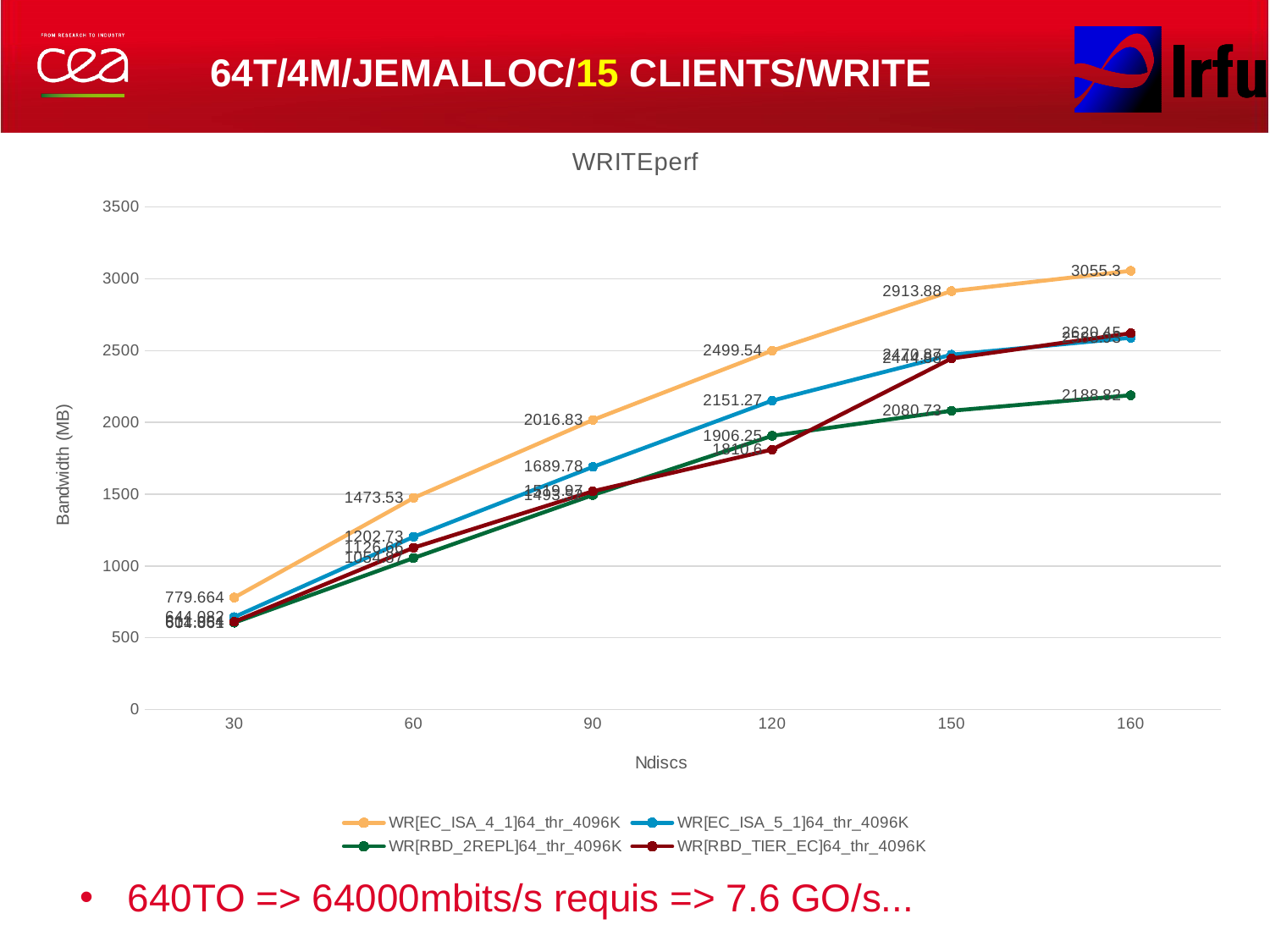
What is the bandwidth for WR[EC_ISA_5_1]64_thr_4096K at 120 Ndiscs? 2151.27 What kind of chart is shown on the slide? line chart How many Ndiscs values are plotted along the x axis of the WRITEperf chart? 6 Does the bandwidth for WR[EC_ISA_4_1]64_thr_4096K rise or fall as Ndiscs increases? rises What is the difference between the WR[EC_ISA_4_1]64_thr_4096K values at 160 and 150 Ndiscs? 141.42 What is the bandwidth for WR[EC_ISA_4_1]64_thr_4096K at 160 Ndiscs? 3055.3 What is the bandwidth for WR[RBD_2REPL]64_thr_4096K at 150 Ndiscs? 2080.73 What is the bandwidth for WR[EC_ISA_4_1]64_thr_4096K at 30 Ndiscs? 779.664 How many series does the legend of the WRITEperf chart list? 4 Which series has the lowest bandwidth at 160 Ndiscs? WR[RBD_2REPL]64_thr_4096K Is the value for WR[RBD_2REPL]64_thr_4096K at 160 Ndiscs greater or less than 2500? less Which series has the highest bandwidth at 160 Ndiscs? WR[EC_ISA_4_1]64_thr_4096K